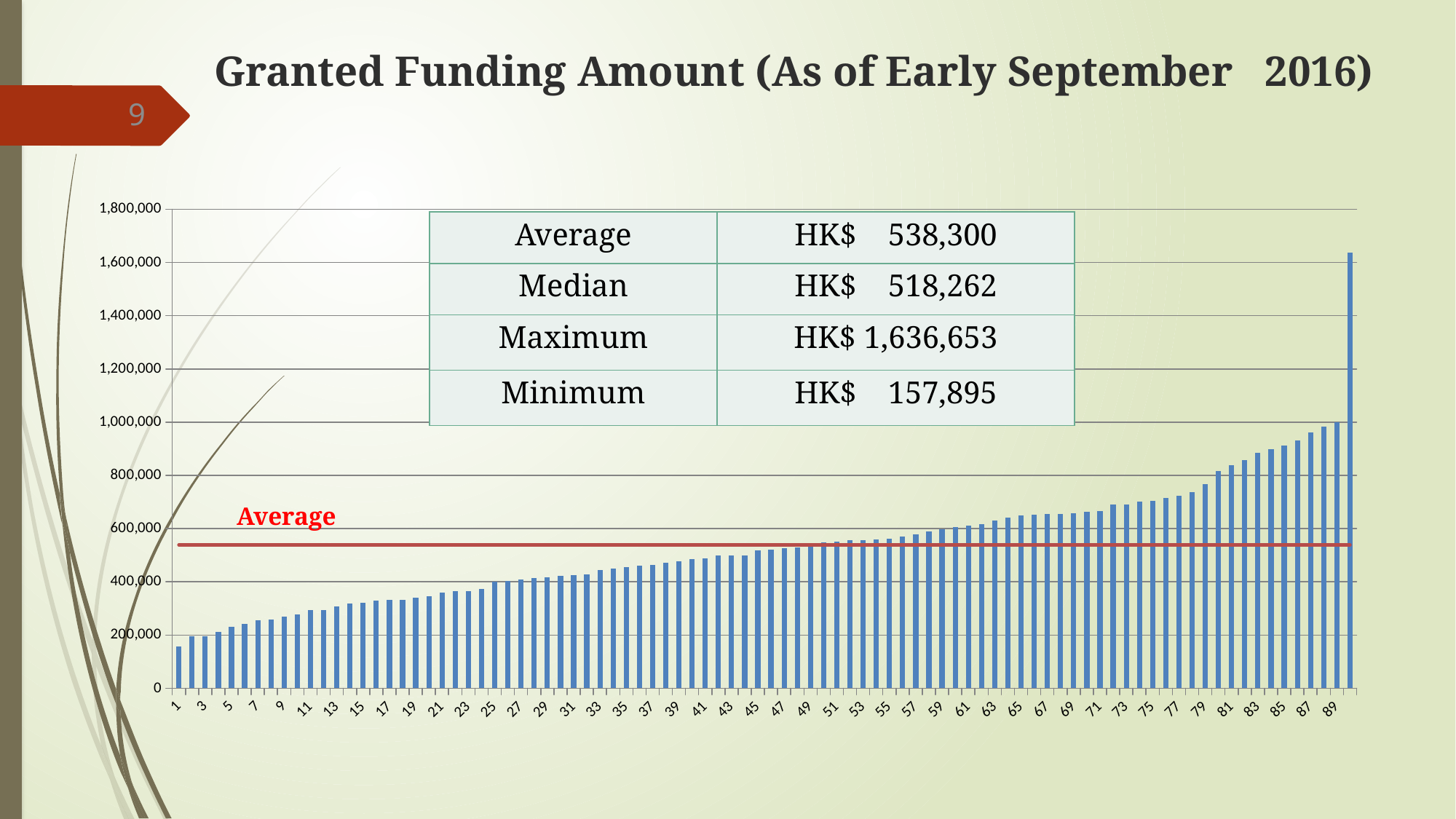
What kind of chart is shown on the slide? bar chart What is the difference between the average and the median granted funding amounts? HK$ 20,038 Is the value for bar 21 greater or less than 400,000? less What is the difference between the maximum and minimum granted funding amounts? HK$ 1,478,758 Do the bar values rise or fall from left to right along the x axis? rise What is the minimum granted funding amount shown in the table? HK$ 157,895 Is the value for bar 1 greater or less than 200,000? less What does the red horizontal line on the chart represent? Average Is the value for bar 81 greater or less than 800,000? greater What is the average granted funding amount shown in the table? HK$ 538,300 What is the maximum granted funding amount shown in the table? HK$ 1,636,653 What is the median granted funding amount shown in the table? HK$ 518,262